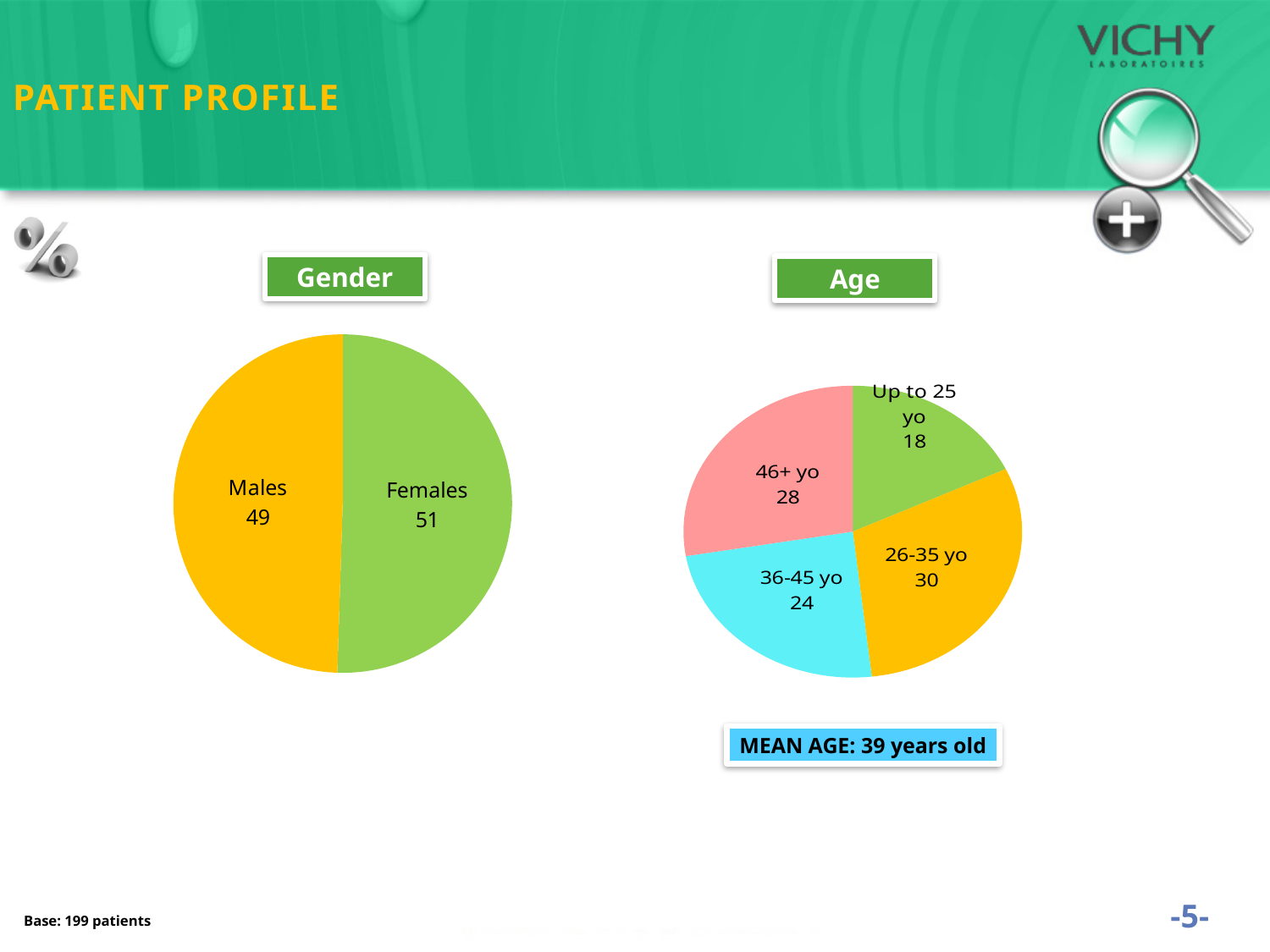
In the Age chart, what is the difference between the 36-45 yo and Up to 25 yo values? 6 What kind of chart is the Gender chart? Pie chart In the Age chart, what is the value for 46+ yo? 28 How many age groups are shown in the Age chart? 4 In the Gender chart, which slice is larger, Males or Females? Females In the Age chart, what is the value for 26-35 yo? 30 In the Age chart, which age group has the highest value? 26-35 yo In the Gender chart, what is the difference between the Females and Males values? 2 In the Age chart, which age group has the lowest value? Up to 25 yo In the Age chart, what is the value for Up to 25 yo? 18 In the Gender chart, what is the value for Males? 49 In the Gender chart, what is the value for Females? 51